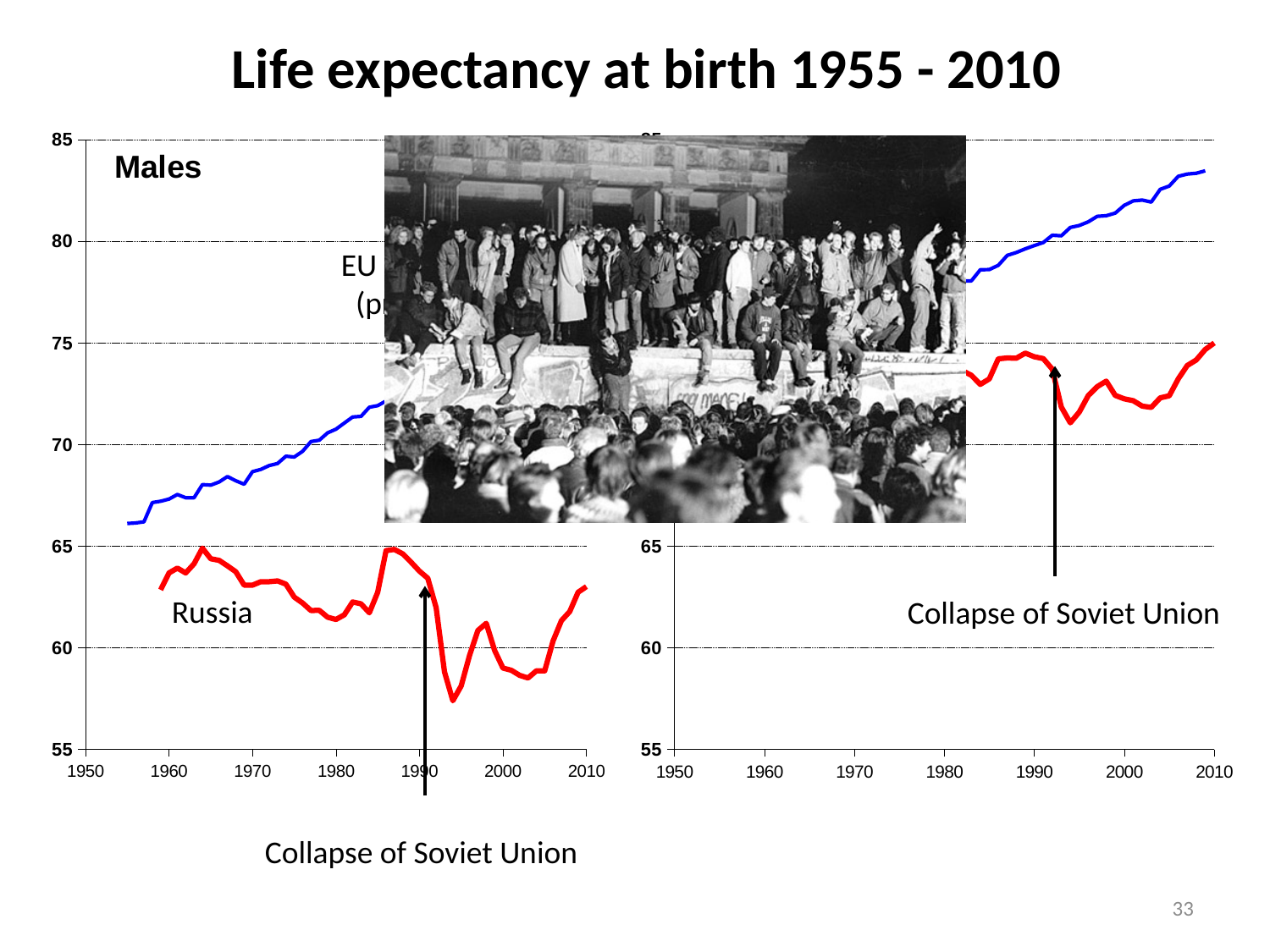
In the right chart, is the value of the red line in 1994 greater or less than 70? greater What event does the arrow annotation on each chart mark? Collapse of Soviet Union In the left chart (Males), is the value for Russia in 2010 greater or less than 65? less In the right chart, is the value of the blue line in 2010 greater or less than 80? greater In the left chart (Males), what colour is the Russia line? red In the left chart (Males), does the EU line rise or fall from 1955 to 1985? rise In the left chart (Males), which line is higher throughout, EU or Russia? EU What kind of chart is the left chart labelled Males? line chart